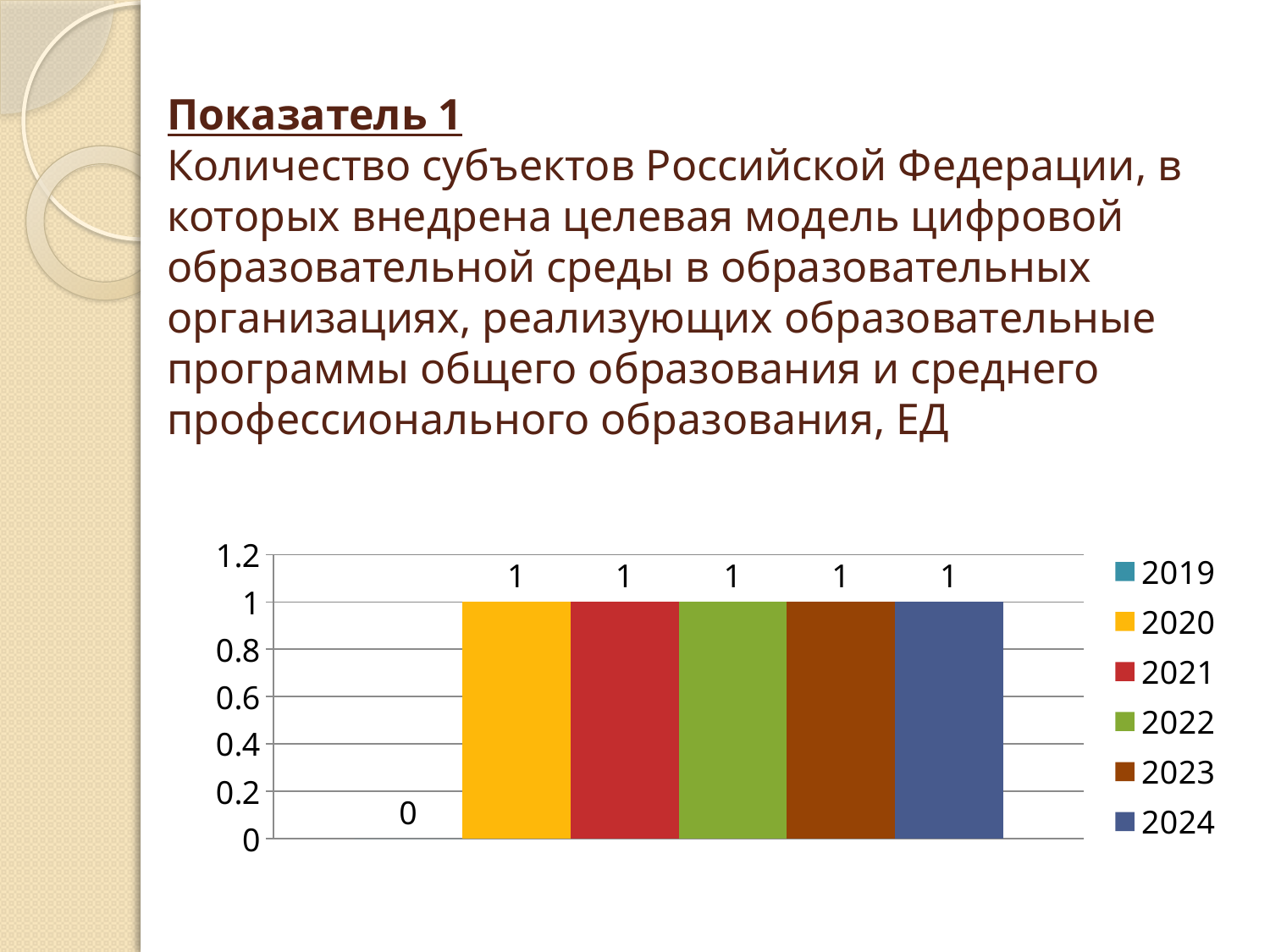
Which is larger, the value for 2019 or the value for 2021? 2021 What is the difference between the values for 2020 and 2019? 1 How many data points are plotted on the chart? 6 What kind of chart is shown on the slide? bar chart What is the value for 2024? 1 What is the value for 2019? 0 What is the highest value shown on the vertical axis? 1.2 What colour is the bar for 2020? yellow What is the value for 2020? 1 Is the value for 2022 greater or less than 0.6? greater How many series does the legend list? 6 Which year has the lowest value? 2019